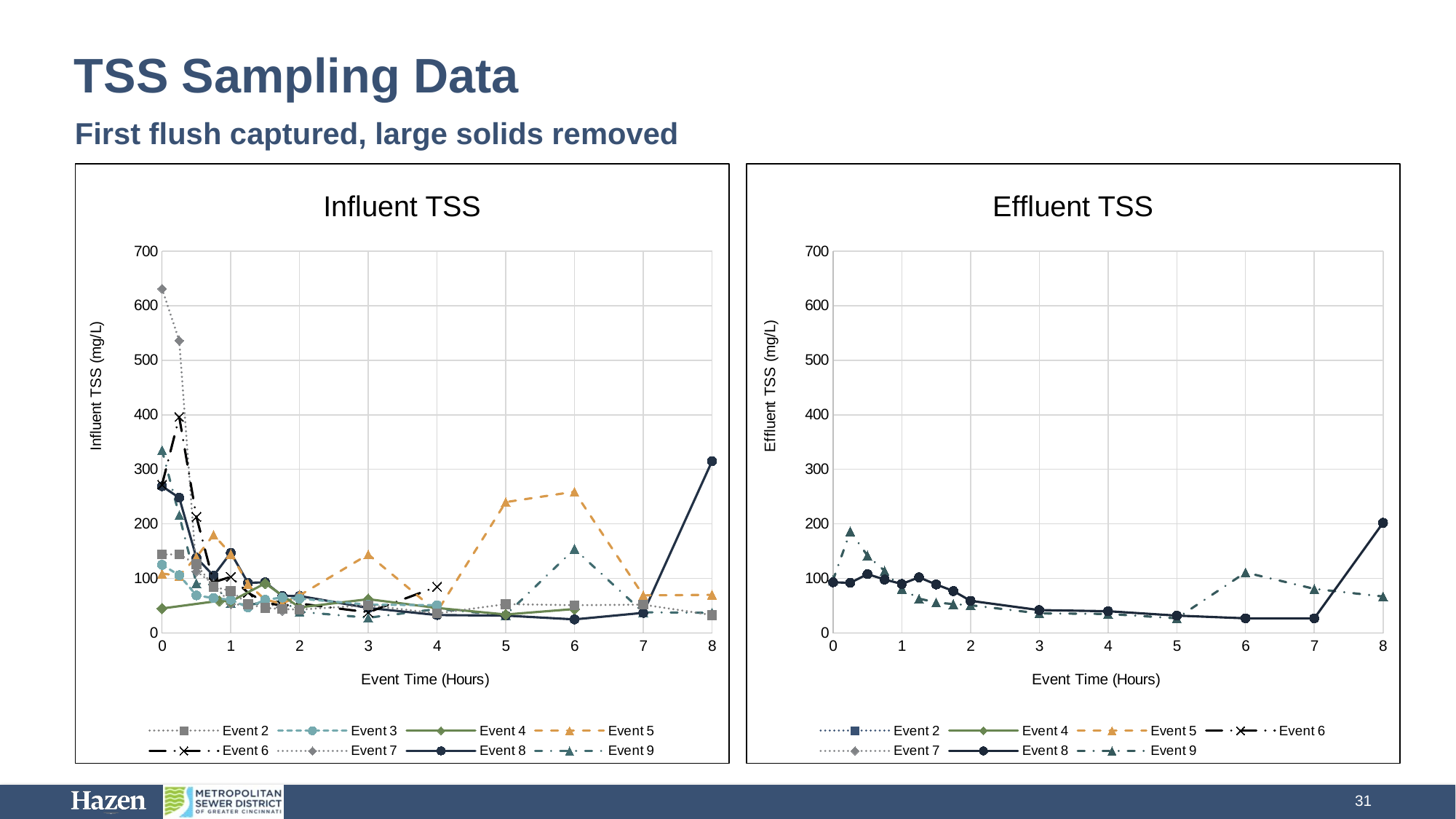
What is the y-axis label of the Influent TSS chart? Influent TSS (mg/L) What is the x-axis label of the Effluent TSS chart? Event Time (Hours) How many series does the legend of the Influent TSS chart list? 8 In the Influent TSS chart, is the value for Event 8 at hour 8 greater or less than 300? greater In the Influent TSS chart, is the value for Event 7 at hour 0 larger or smaller than the value for Event 8 at hour 0? larger How many series does the legend of the Effluent TSS chart list? 7 In the Influent TSS chart, which series has the highest value at hour 0? Event 7 In the Effluent TSS chart, which series has the highest value at hour 8? Event 8 In the Influent TSS chart, is the value for Event 5 at hour 6 greater or less than 200? greater What type of chart is the Influent TSS chart? line chart In the Influent TSS chart, is the value for Event 7 at hour 0 greater or less than 600? greater